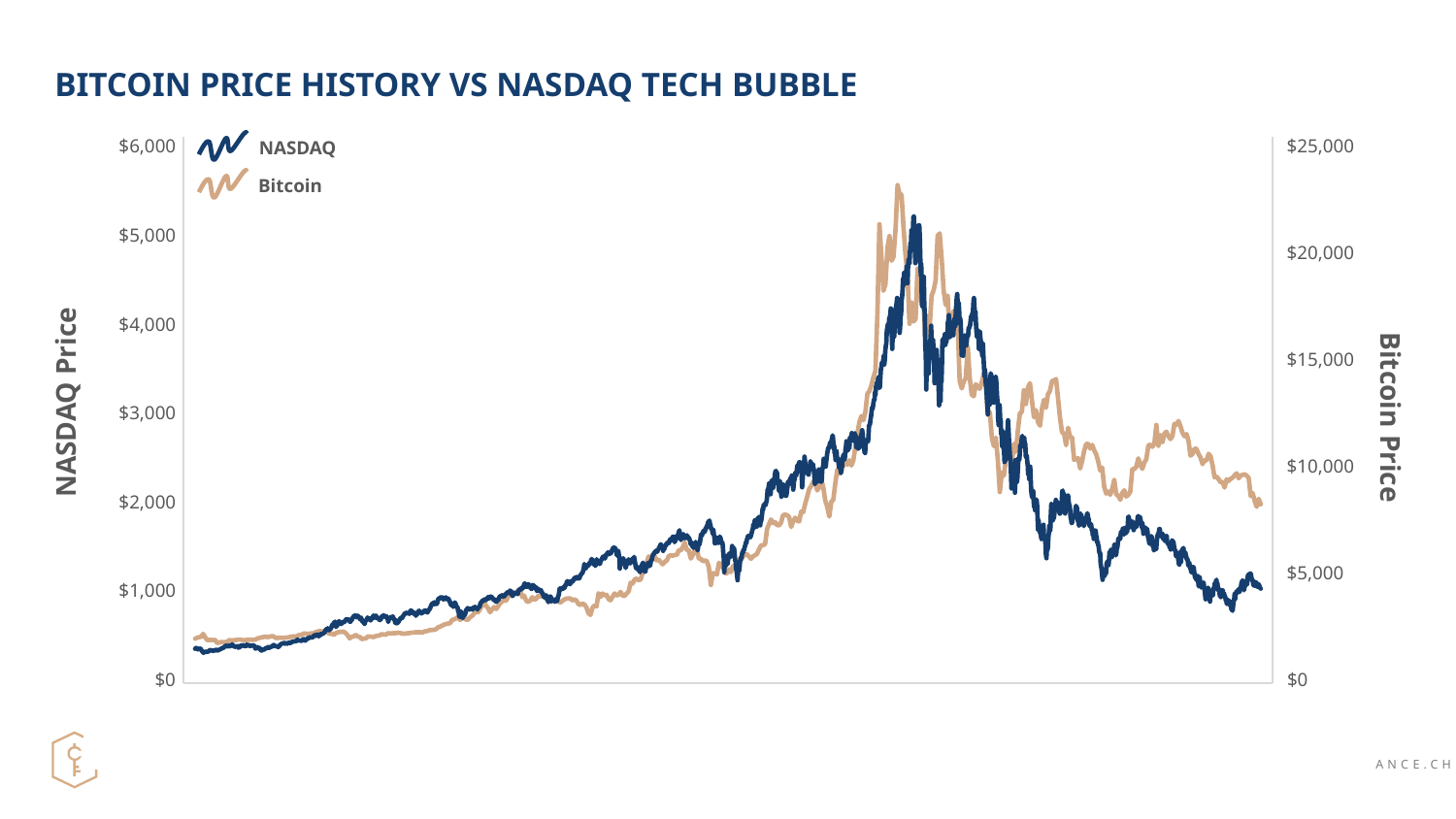
Do the Bitcoin values rise or fall from the peak to the right end of the line? fall What is the highest tick label on the right-hand Bitcoin Price axis? $25,000 Is the peak value of the NASDAQ line greater or less than $4,000 on the left axis? greater Is the Bitcoin value at the right end of the line greater or less than $10,000? less Do the NASDAQ values rise or fall from the start of the line to its peak? rise Which series is plotted in dark blue? NASDAQ How many series does the legend list? 2 What kind of chart is shown on the slide? Line chart Is the NASDAQ value at the right end of the line greater or less than $2,000? less What is the title of the chart? BITCOIN PRICE HISTORY VS NASDAQ TECH BUBBLE